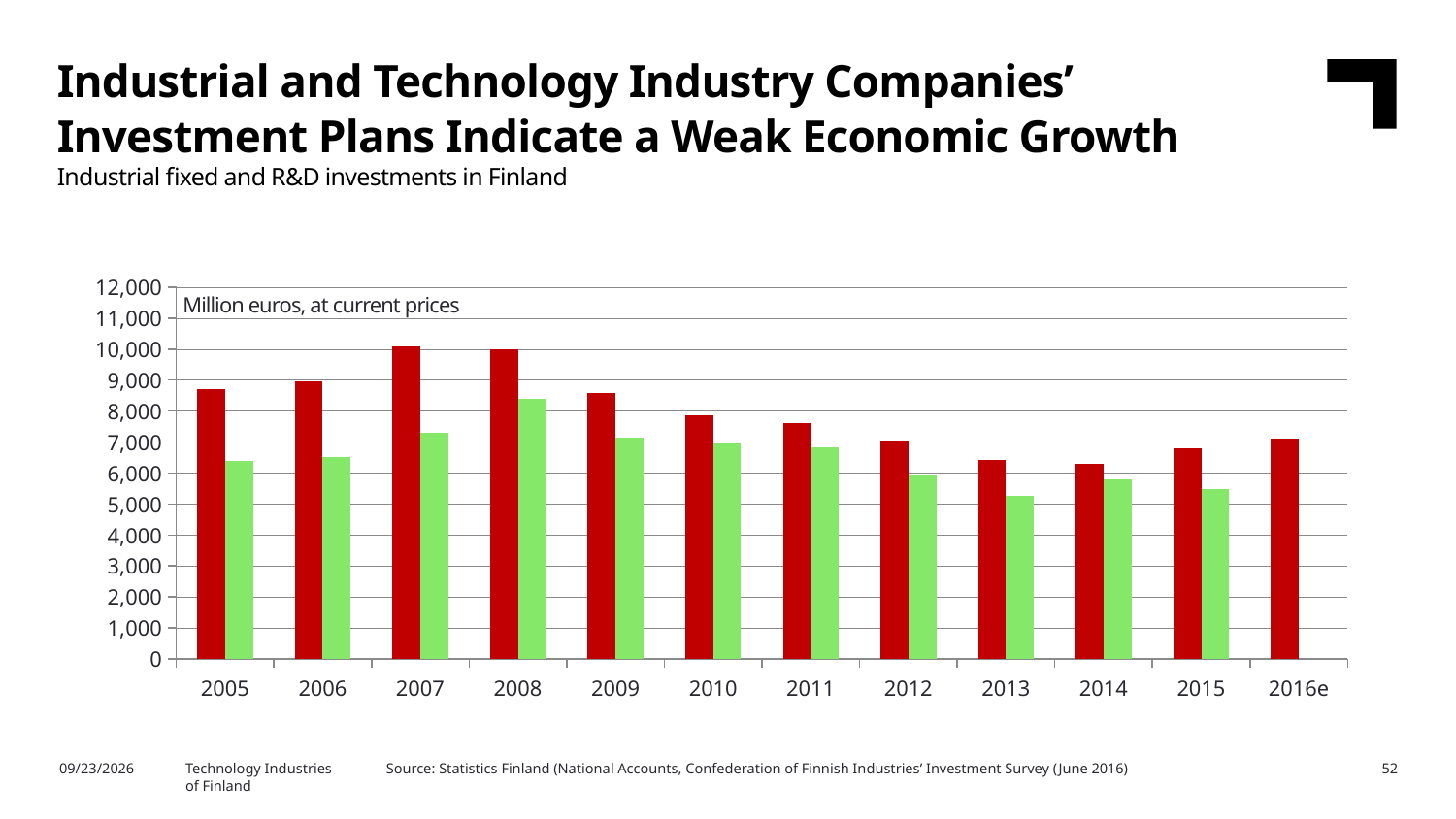
Is the green bar for 2008 greater or less than 8,000? greater How many years are shown on the x axis of the chart? 12 Which is larger in 2012, the red bar or the green bar? the red bar Is the red bar for 2005 greater or less than 8,000? greater Which year has the shortest green bar? 2013 Which is larger, the red bar for 2008 or the red bar for 2013? 2008 What unit is stated in the text box inside the chart? Million euros, at current prices What type of chart is shown on the slide? bar chart Which year has the tallest green bar? 2008 Is the green bar for 2013 greater or less than 6,000? less Do the red bars generally rise or fall from 2008 to 2014? fall